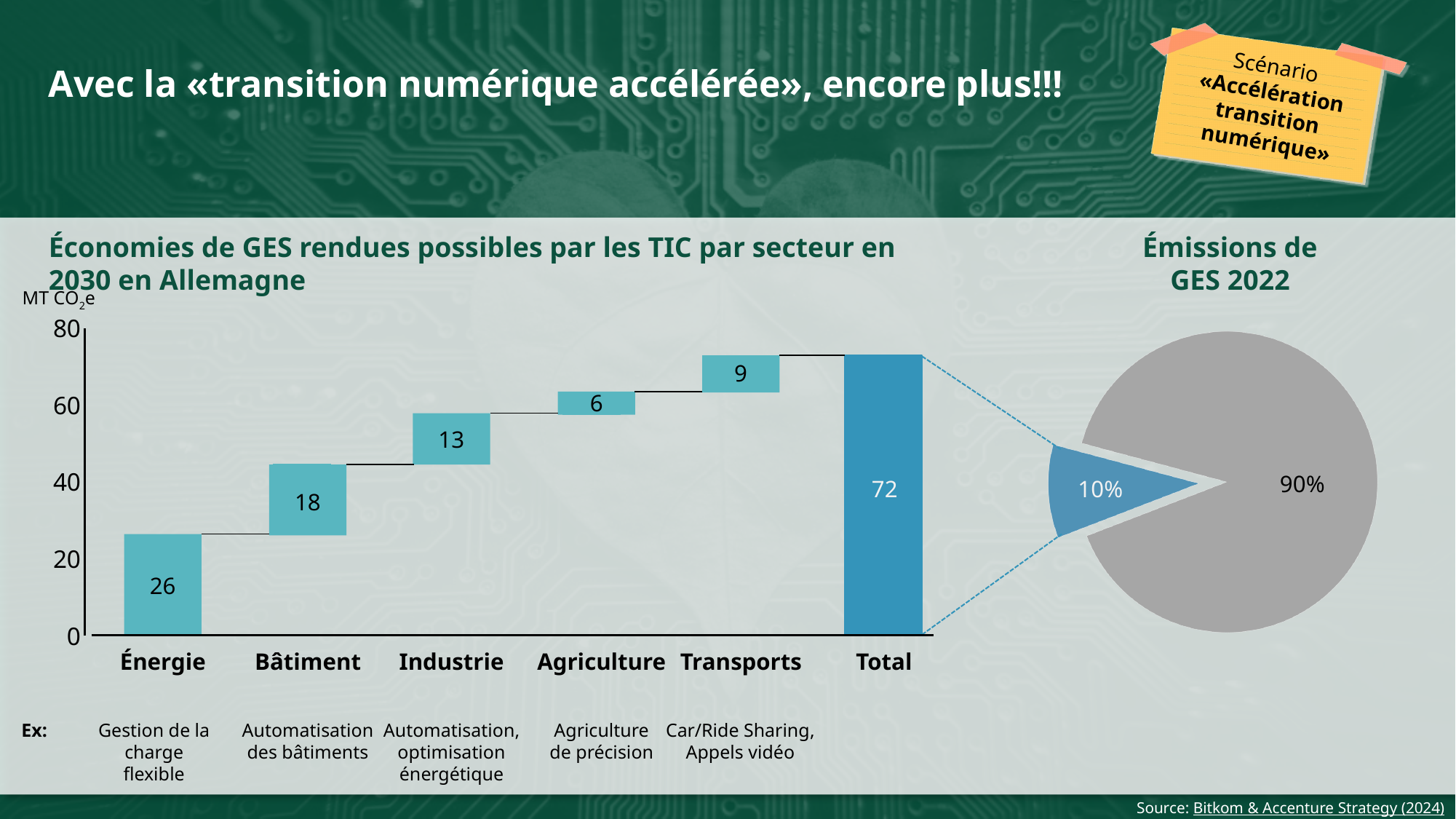
In the chart 'Économies de GES rendues possibles par les TIC par secteur en 2030 en Allemagne', how many sectors are shown, excluding the Total bar? 5 In the chart 'Économies de GES rendues possibles par les TIC par secteur en 2030 en Allemagne', what is the value for Bâtiment? 18 In the chart 'Économies de GES rendues possibles par les TIC par secteur en 2030 en Allemagne', which is larger, the value for Transports or the value for Agriculture? Transports What unit is shown on the y axis of the chart 'Économies de GES rendues possibles par les TIC par secteur en 2030 en Allemagne'? MT CO2e What kind of chart is 'Économies de GES rendues possibles par les TIC par secteur en 2030 en Allemagne'? Bar chart In the chart 'Économies de GES rendues possibles par les TIC par secteur en 2030 en Allemagne', what is the value for Énergie? 26 In the chart 'Économies de GES rendues possibles par les TIC par secteur en 2030 en Allemagne', which sector has the highest savings? Énergie In the chart 'Économies de GES rendues possibles par les TIC par secteur en 2030 en Allemagne', which sector has the lowest savings? Agriculture In the chart 'Économies de GES rendues possibles par les TIC par secteur en 2030 en Allemagne', what is the difference between the values for Énergie and Industrie? 13 In the chart 'Économies de GES rendues possibles par les TIC par secteur en 2030 en Allemagne', what is the value of the Total bar? 72 In the pie chart 'Émissions de GES 2022', what share does the blue slice represent? 10% In the chart 'Économies de GES rendues possibles par les TIC par secteur en 2030 en Allemagne', what is the value for Transports? 9